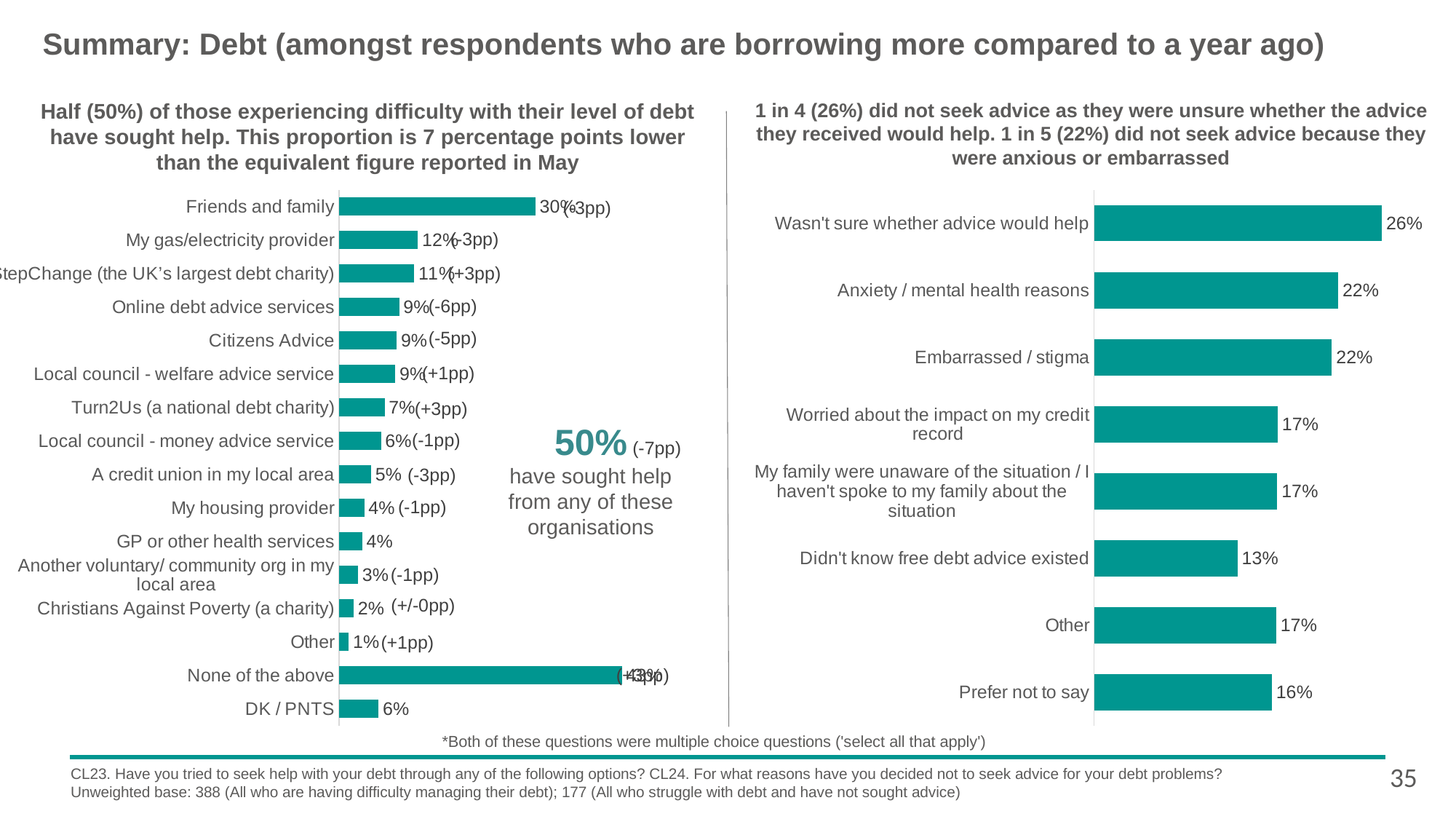
In the right-hand chart, what is the difference between 'Wasn't sure whether advice would help' and 'Didn't know free debt advice existed'? 13 percentage points In the right-hand chart, which reason for not seeking advice has the lowest value? Didn't know free debt advice existed In the right-hand chart, what percentage of respondents said they weren't sure whether advice would help? 26% In the right-hand chart, what is the value for 'Prefer not to say'? 16% In the left-hand chart, what is the difference between 'Friends and family' and 'StepChange (the UK's largest debt charity)'? 19 percentage points What type of chart is used on the right-hand side of the slide? Bar chart In the right-hand chart, how many reasons for not seeking advice are listed? 8 According to the left-hand chart, what percentage have sought help from any of these organisations? 50% In the left-hand chart, what is the value for 'My gas/electricity provider'? 12% In the right-hand chart, which reason for not seeking advice has the highest value? Wasn't sure whether advice would help In the left-hand chart, which is larger: 'Turn2Us (a national debt charity)' or 'A credit union in my local area'? Turn2Us (a national debt charity) In the left-hand chart, what percentage sought help from friends and family? 30%